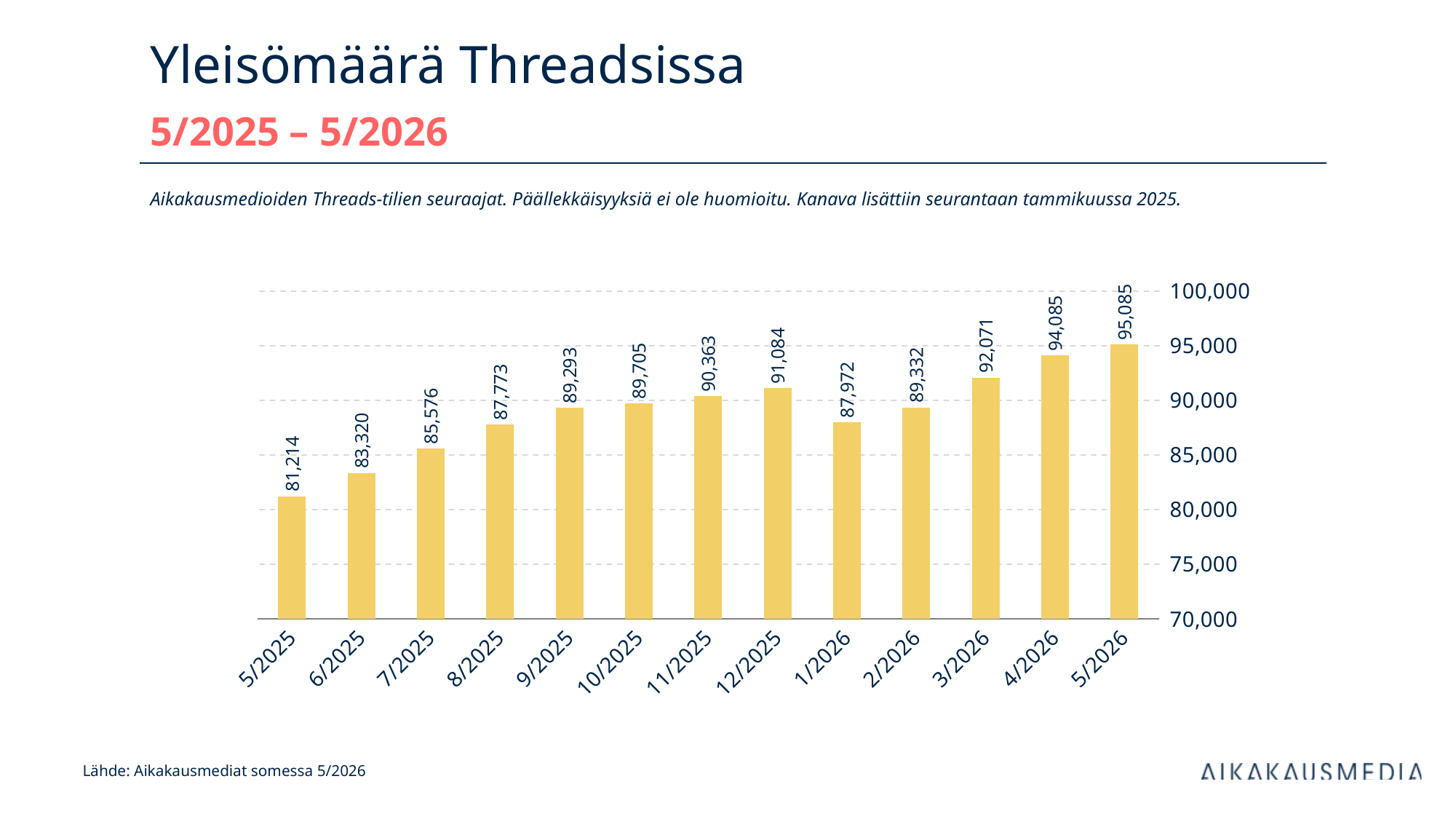
What is the difference between the values for 5/2026 and 4/2026? 1,000 What is the difference between the values for 12/2025 and 1/2026? 3,112 Is the value for 3/2026 greater or less than 90,000? greater How many months are shown on the x axis? 13 What kind of chart is shown on the slide? bar chart What is the value for 12/2025? 91,084 What is the value for 5/2025? 81,214 What is the title of the chart on the slide? Yleisömäärä Threadsissa Which is larger, the value for 11/2025 or the value for 2/2026? 11/2025 Which month has the lowest value? 5/2025 What is the value for 1/2026? 87,972 Which month has the highest value? 5/2026